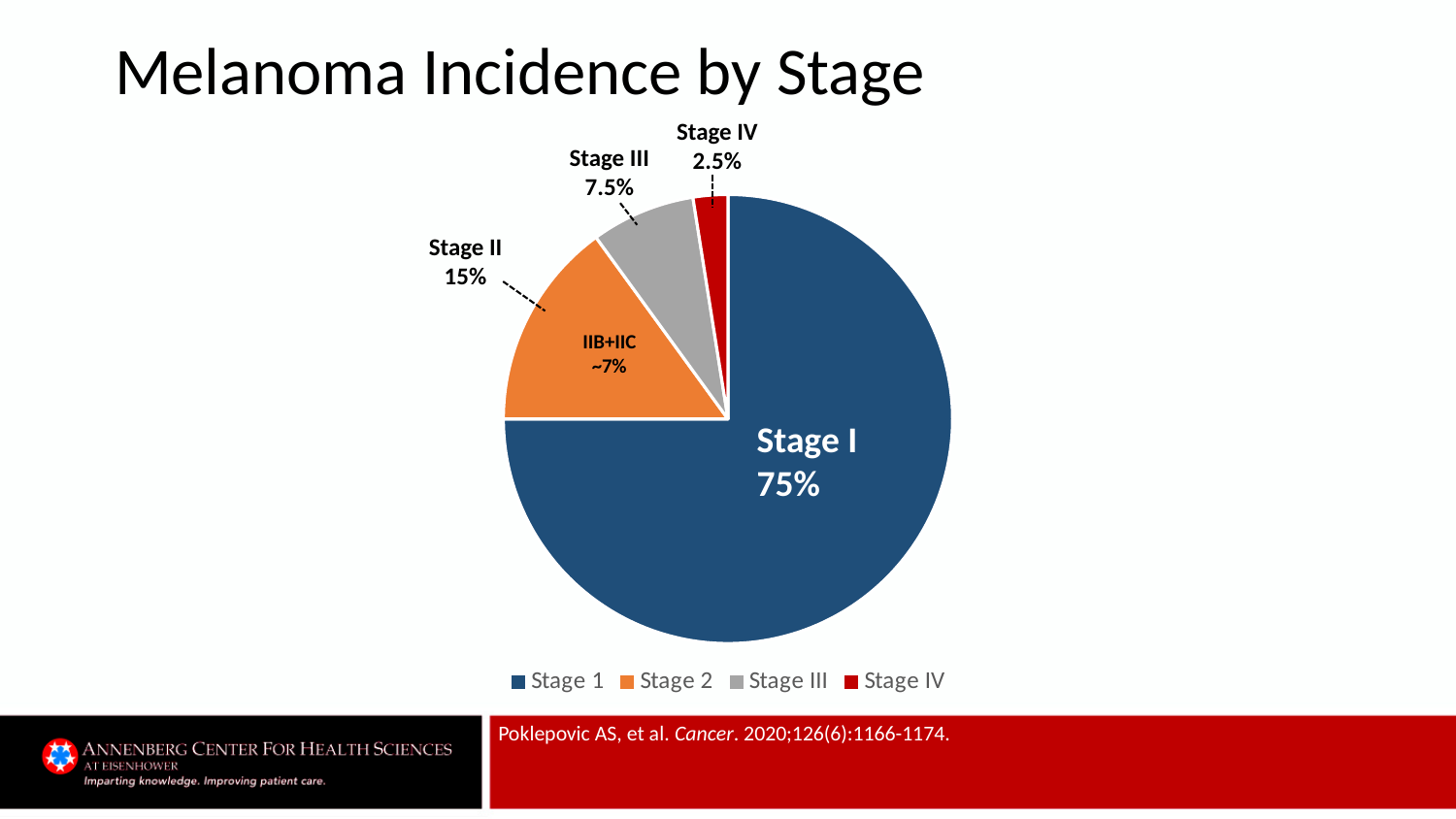
Which stage has the smallest share of melanoma incidence? Stage IV What is the title of the chart? Melanoma Incidence by Stage What share of melanoma incidence is Stage I? 75% Which stage has the largest share of melanoma incidence? Stage I What share of melanoma incidence is Stage III? 7.5% What share of melanoma incidence is Stage IV? 2.5% How many slices does the pie chart have? 4 What is the difference in percentage points between the Stage I and Stage II shares? 60 What is the difference in percentage points between the Stage II and Stage III shares? 7.5 Which has a larger share, Stage III or Stage IV? Stage III What share of melanoma incidence is Stage II? 15% What kind of chart is shown on the slide? Pie chart